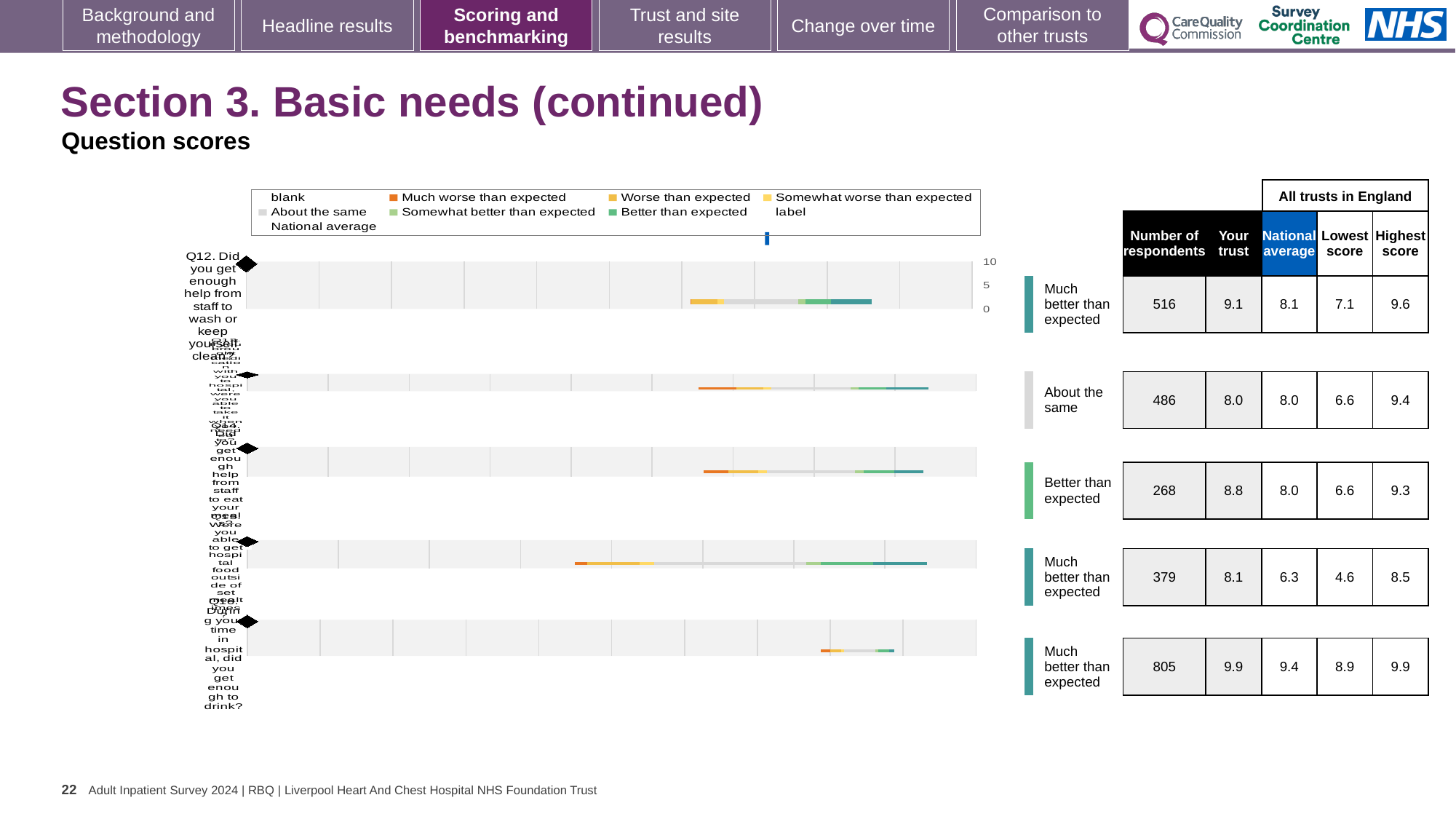
Which row has the highest 'Your trust' score? the bottom row (Q16), 9.9 For the third row (Q14), which is larger: the 'Your trust' score or the national average? Your trust (8.8) What is the 'Your trust' score for the top row (Q12)? 9.1 In the chart legend, what does the blue marker represent? National average How many question bars are plotted in the chart? 5 What is the national average for the top row (Q12)? 8.1 How many respondents are listed for the top row (Q12, help from staff to wash or keep yourself clean)? 516 What kind of chart is shown on the slide? bar chart Which row has the lowest 'Your trust' score? the second row (Q13), 8.0 For the fourth row (Q15), what is the difference between the 'Your trust' score and the national average? 1.8 What benchmark rating is shown for the second row (Q13)? About the same In the chart legend, which colour represents 'Much worse than expected'? orange